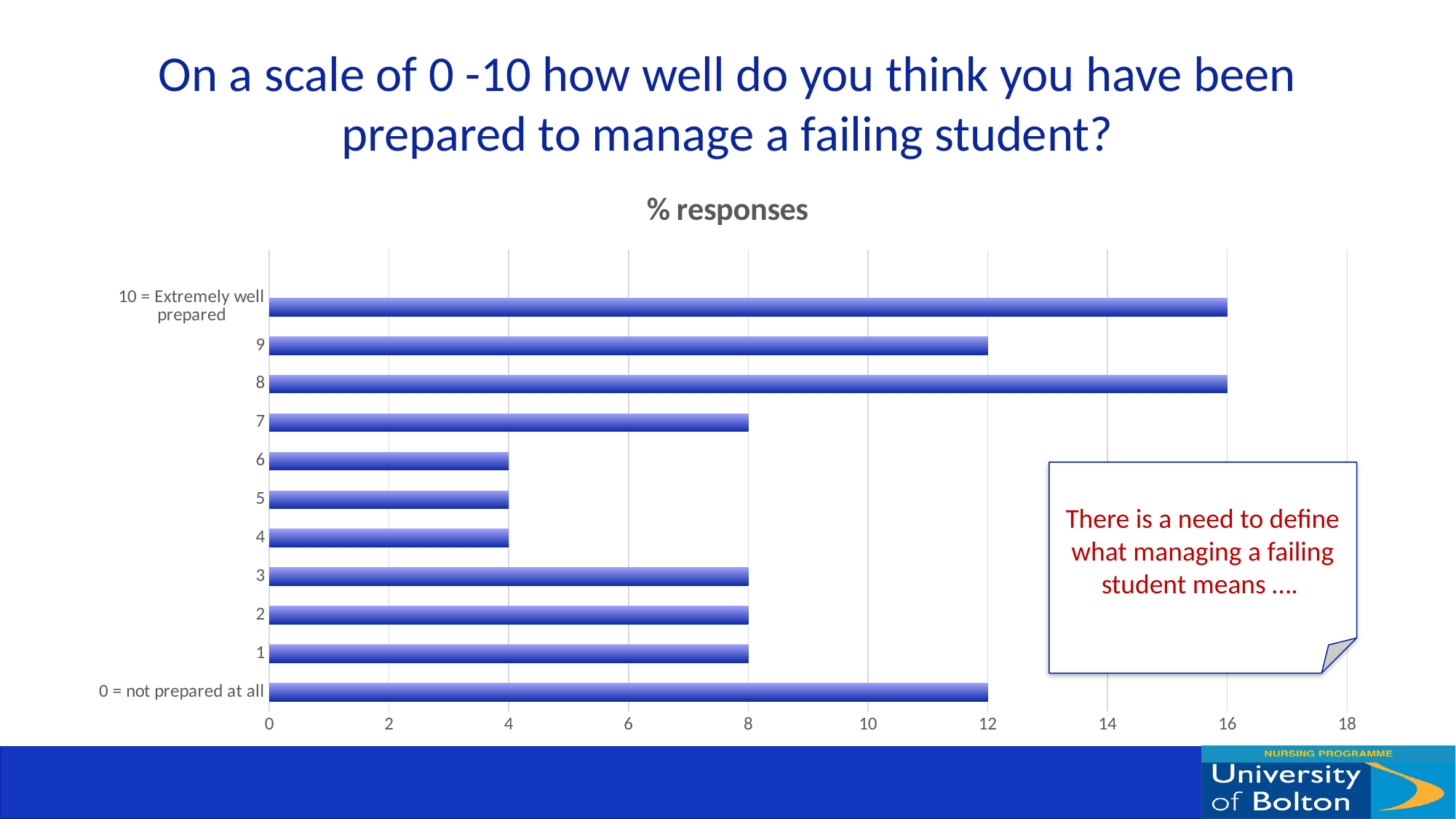
What is the value for the category '7' in the '% responses' chart? 8 Which is larger, the value for '9' or the value for '6'? 9 What kind of chart is shown on the slide? bar chart How many categories are shown on the chart? 11 Is the value for '8' greater or less than 14? greater What is the difference between the values for '8' and '7'? 8 What is the title of the chart? % responses What is the value for the category '5'? 4 What is the value for the category '9'? 12 What is the value for '10 = Extremely well prepared'? 16 What is the value for '0 = not prepared at all'? 12 What is the difference between the values for '0 = not prepared at all' and '4'? 8